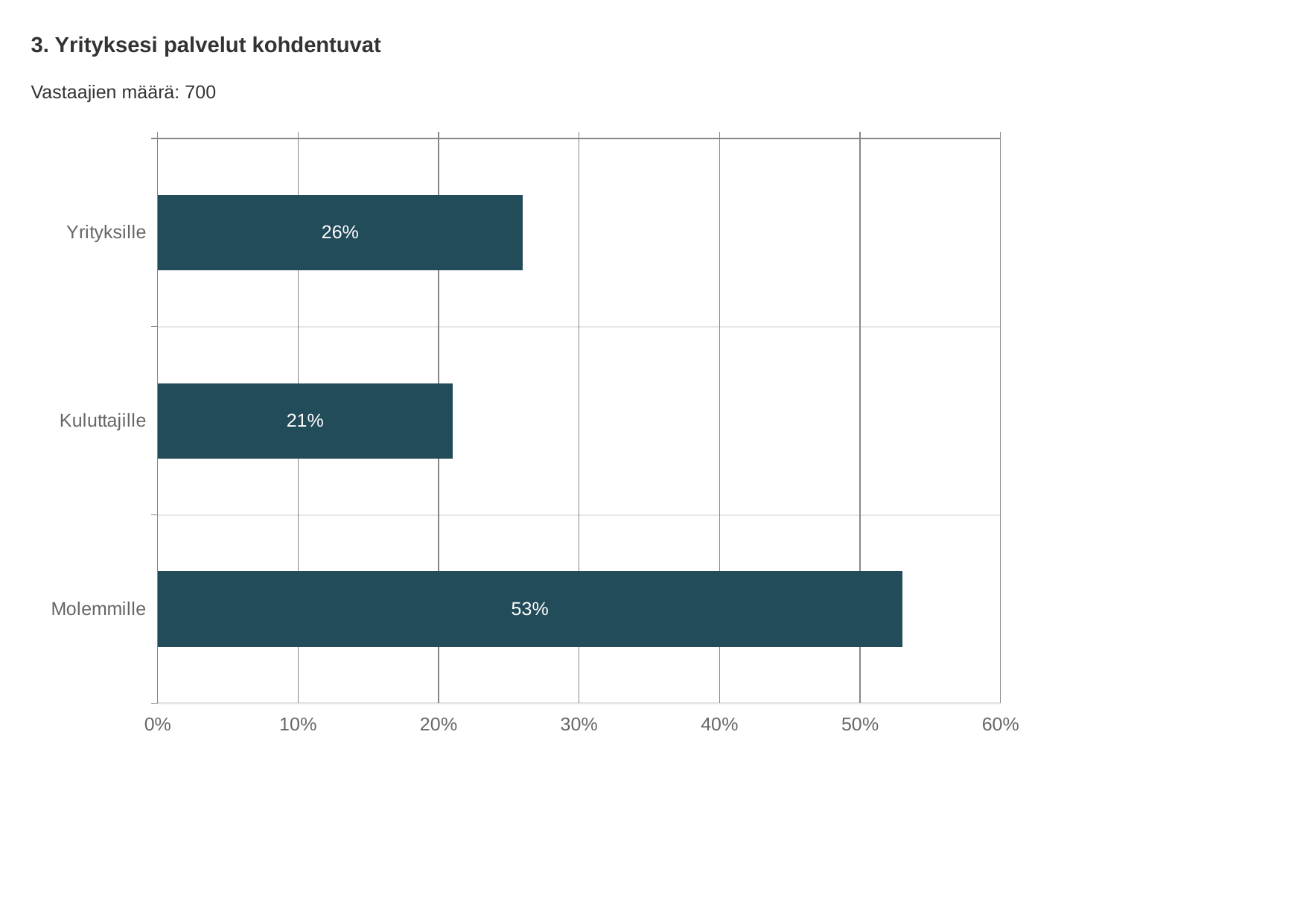
Is the value for Molemmille greater or less than 50%? greater What is the value for Kuluttajille? 21% What is the value for Yrityksille? 26% What is the difference between the values for Molemmille and Yrityksille? 27% What is the value for Molemmille? 53% What is the number of respondents (Vastaajien määrä) stated on the slide? 700 What is the difference between the values for Yrityksille and Kuluttajille? 5% What kind of chart is shown on the slide? bar chart Which category has the lowest value? Kuluttajille Which is larger, the value for Yrityksille or the value for Kuluttajille? Yrityksille How many categories are shown in the chart? 3 Which category has the highest value? Molemmille